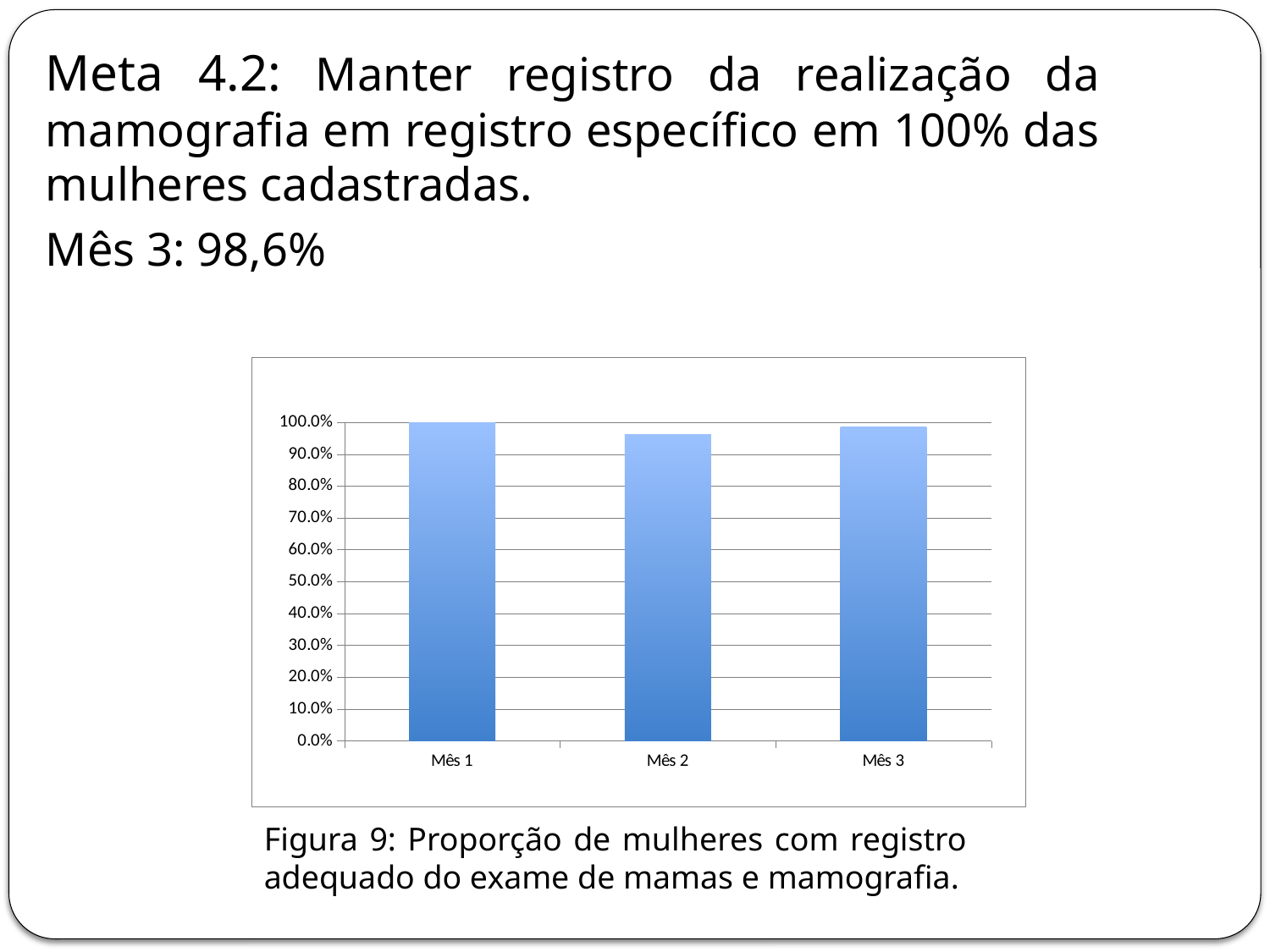
What colour are the bars in the chart? blue Which is larger, the value for Mês 1 or the value for Mês 2? Mês 1 What kind of chart is shown on the slide? bar chart Is the value for Mês 3 greater or less than 90.0%? greater What is the value for Mês 1 in the chart? 100.0% Which month has the lowest bar in the chart? Mês 2 Does the value rise or fall from Mês 1 to Mês 2? fall What is the figure number given in the caption below the chart? Figura 9 How many months are shown on the x axis of the chart? 3 Is the value for Mês 2 greater or less than 90.0%? greater Which month has the highest bar in the chart? Mês 1 Which is larger, the value for Mês 2 or the value for Mês 3? Mês 3